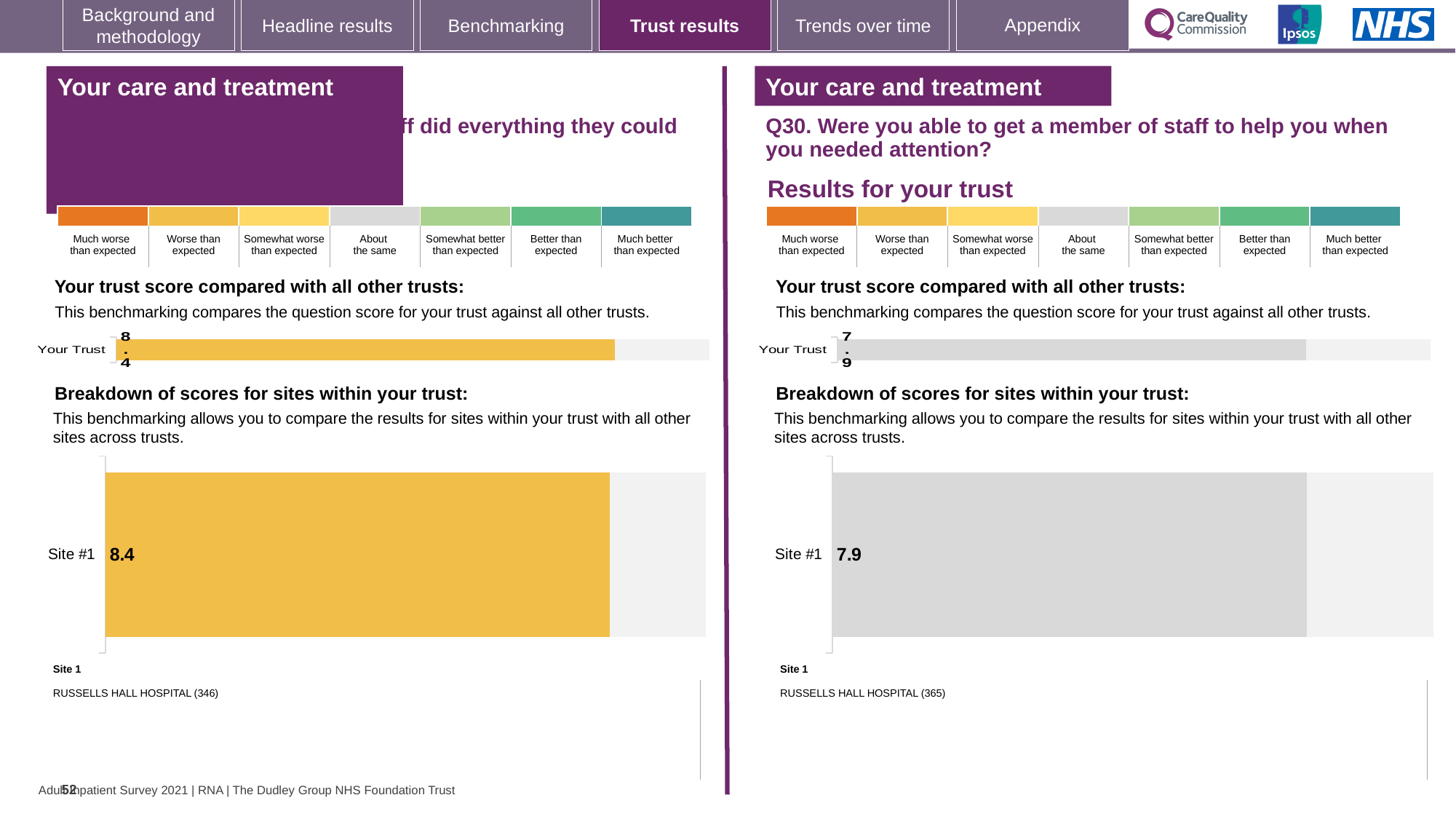
Which site is listed as Site 1 beneath the left-hand site breakdown chart? RUSSELLS HALL HOSPITAL (346) In the left-hand 'Breakdown of scores for sites within your trust' chart, what is the score for Site #1? 8.4 Which is larger: the trust score in the left-hand 'Your Trust' chart or the trust score in the right-hand 'Your Trust' chart? The left-hand chart (8.4) What colour is the Site #1 bar in the right-hand site breakdown chart for Q30? Grey Is the Site #1 score in the left-hand site breakdown chart greater or less than 8? greater On the left-hand side of the slide, what is the trust score shown in the 'Your trust score compared with all other trusts' bar chart? 8.4 Is the trust score in the right-hand 'Your Trust' chart (Q30) greater or less than 8? less On the right-hand side of the slide (Q30), what is the trust score shown in the 'Your trust score compared with all other trusts' bar chart? 7.9 What type of chart is used to show the Site #1 score in the left-hand site breakdown? Bar chart What is the difference between the Site #1 score in the left-hand site breakdown chart and the Site #1 score in the right-hand site breakdown chart? 0.5 How many sites are shown in the right-hand 'Breakdown of scores for sites within your trust' chart? 1 In the right-hand 'Breakdown of scores for sites within your trust' chart (Q30), what is the score for Site #1? 7.9